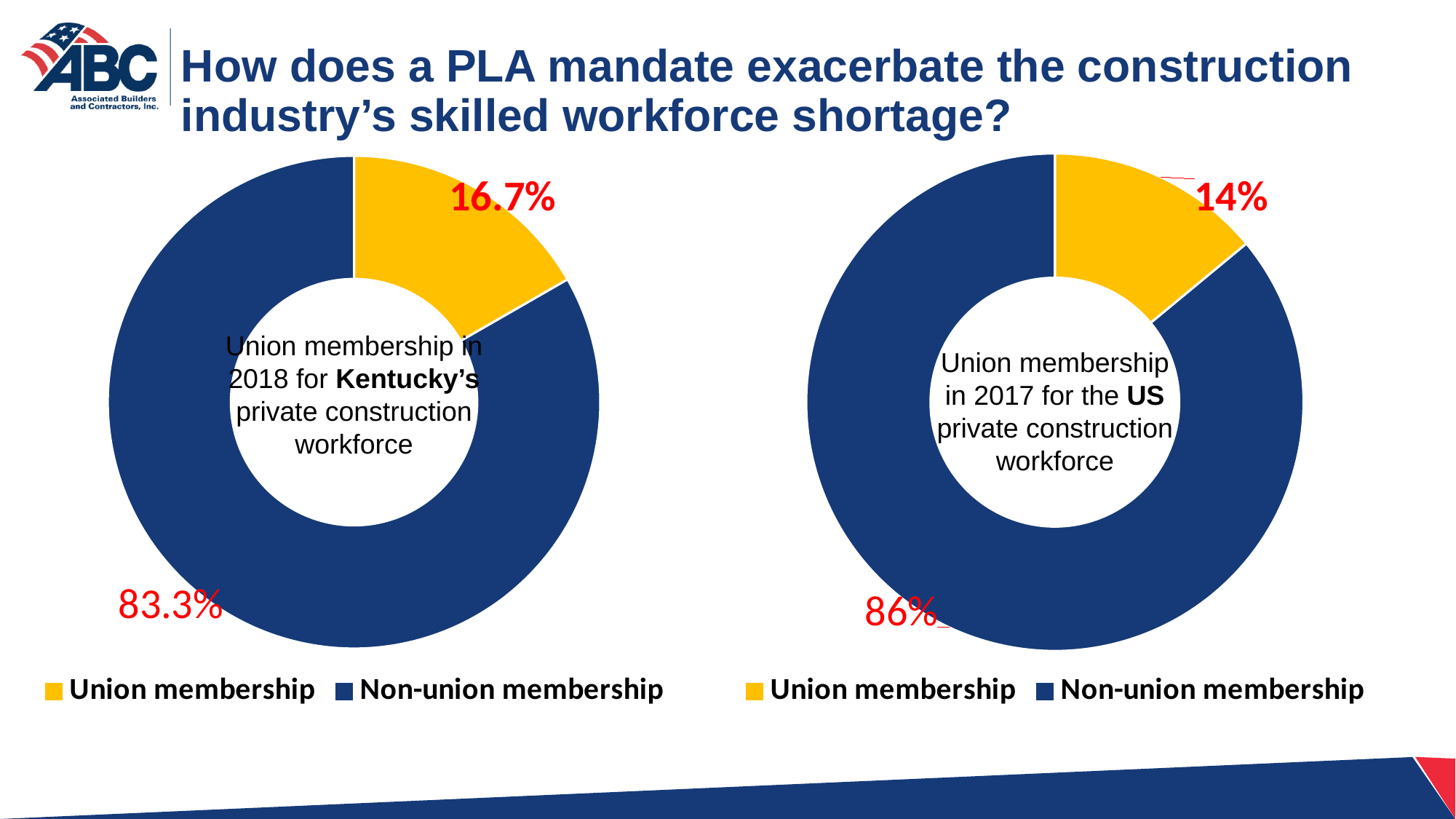
What kind of chart is used on the left of the slide? Doughnut (pie) chart In the left chart (Kentucky), what is the difference between the non-union and union membership shares? 66.6% In the right chart (US private construction workforce, 2017), what share is union membership? 14% In the left chart (Kentucky's private construction workforce, 2018), what share is non-union membership? 83.3% In the right chart (US), which category has the smaller share? Union membership In the right chart (US), what is the difference between the non-union and union membership shares? 72% How many categories does the legend of the right chart list? 2 In the left chart (Kentucky), which category has the larger share? Non-union membership Is the union membership share larger in the left chart (Kentucky, 2018) or the right chart (US, 2017)? Left chart (Kentucky, 2018) In the left chart, what colour represents union membership? Yellow In the right chart (US private construction workforce, 2017), what share is non-union membership? 86% In the left chart (Kentucky's private construction workforce, 2018), what share is union membership? 16.7%